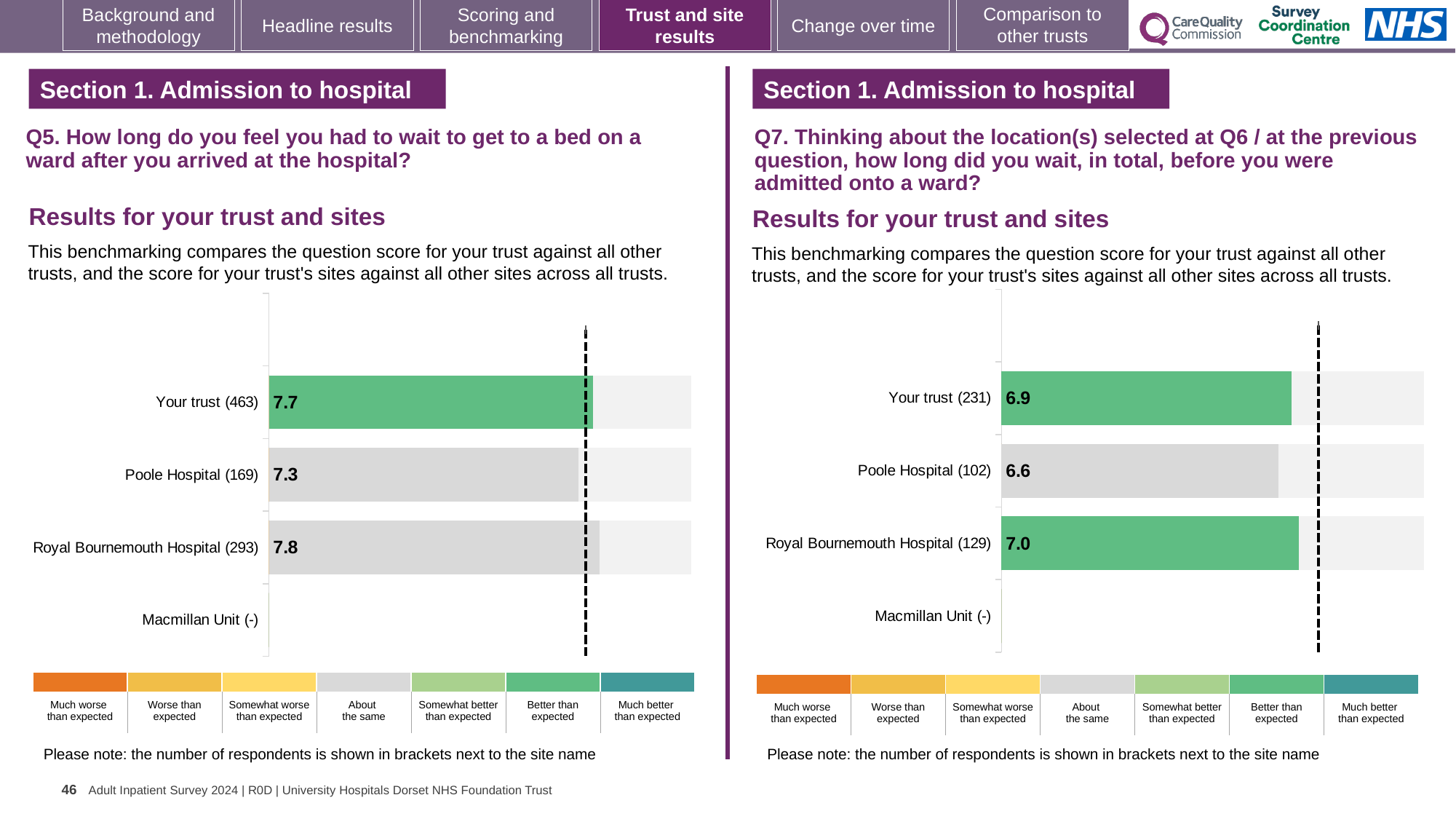
What kind of chart is used on the Q5 chart (left)? Bar chart On the Q7 chart (right), is the score for Your trust or Poole Hospital larger? Your trust On the Q5 chart (left), how many respondents are shown for Your trust? 463 How many categories (rows) are listed on the Q7 chart (right)? 4 On the Q5 chart (left), what is the difference between the scores for Royal Bournemouth Hospital and Poole Hospital? 0.5 On the Q7 chart (right), how many respondents are shown for Poole Hospital? 102 On the Q7 chart (right), what is the score for Royal Bournemouth Hospital? 7.0 On the Q7 chart (right), which site or trust has the lowest score? Poole Hospital On the Q5 chart (left), which site or trust has the highest score? Royal Bournemouth Hospital On the Q5 chart (left), what is the score for Your trust? 7.7 On the Q7 chart (right), what is the difference between the scores for Your trust and Poole Hospital? 0.3 On the Q5 chart (left), what is the score for Poole Hospital? 7.3